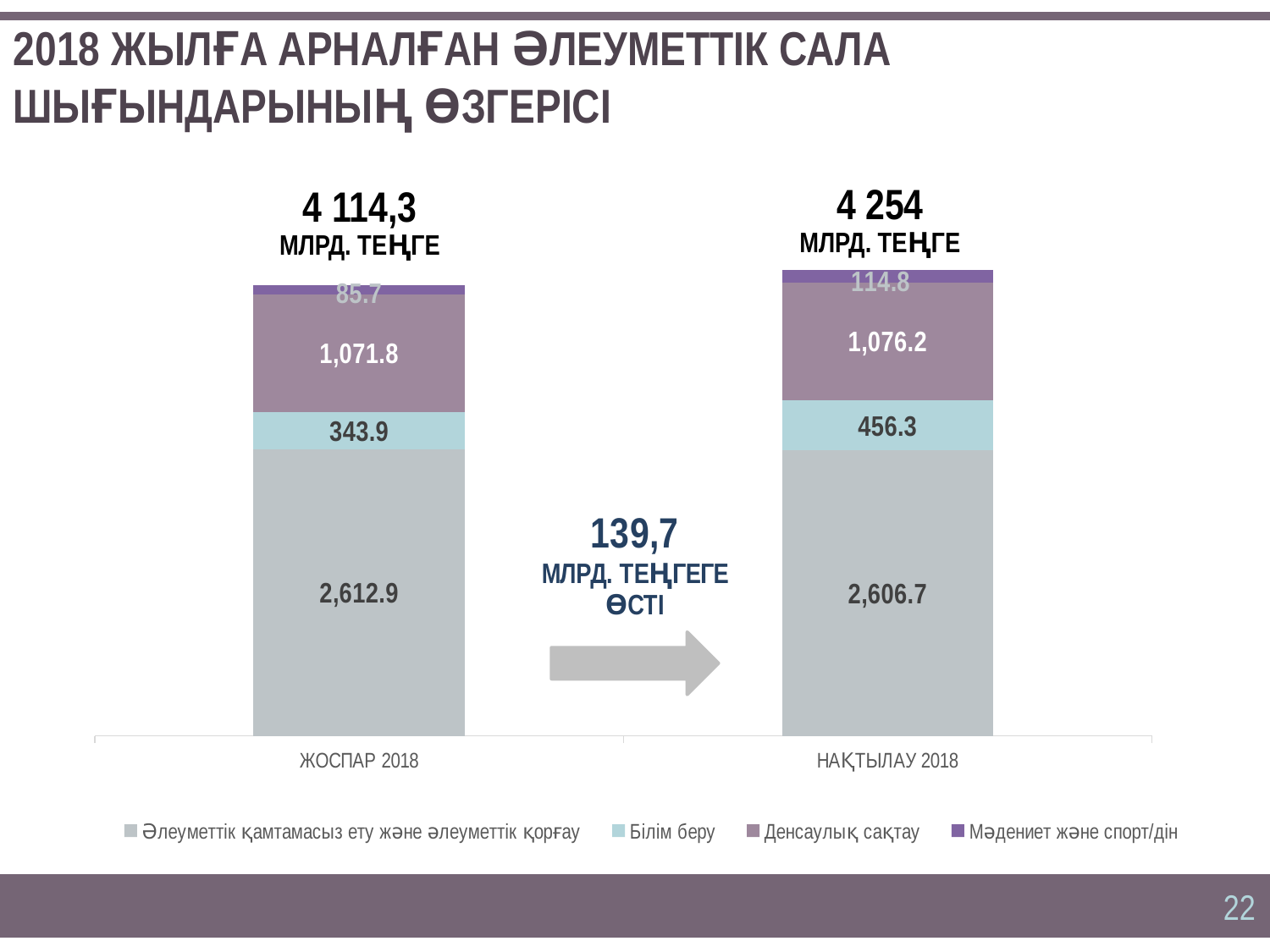
What is the total of the stacked bar for ЖОСПАР 2018? 4 114,3 млрд. теңге What is the value of Мәдениет және спорт/дін for ЖОСПАР 2018? 85.7 What is the value of Білім беру for ЖОСПАР 2018? 343.9 What is the value of Денсаулық сақтау for НАҚТЫЛАУ 2018? 1,076.2 How many series does the legend list? 4 How many categories are shown on the x axis? 2 What is the difference in Білім беру between НАҚТЫЛАУ 2018 and ЖОСПАР 2018? 112.4 What is the total of the stacked bar for НАҚТЫЛАУ 2018? 4 254 млрд. теңге What is the value of Білім беру for НАҚТЫЛАУ 2018? 456.3 Which series has the largest value in the НАҚТЫЛАУ 2018 bar? Әлеуметтік қамтамасыз ету және әлеуметтік қорғау What type of chart is shown on the slide? stacked bar chart Which is larger: Мәдениет және спорт/дін for ЖОСПАР 2018 or for НАҚТЫЛАУ 2018? НАҚТЫЛАУ 2018